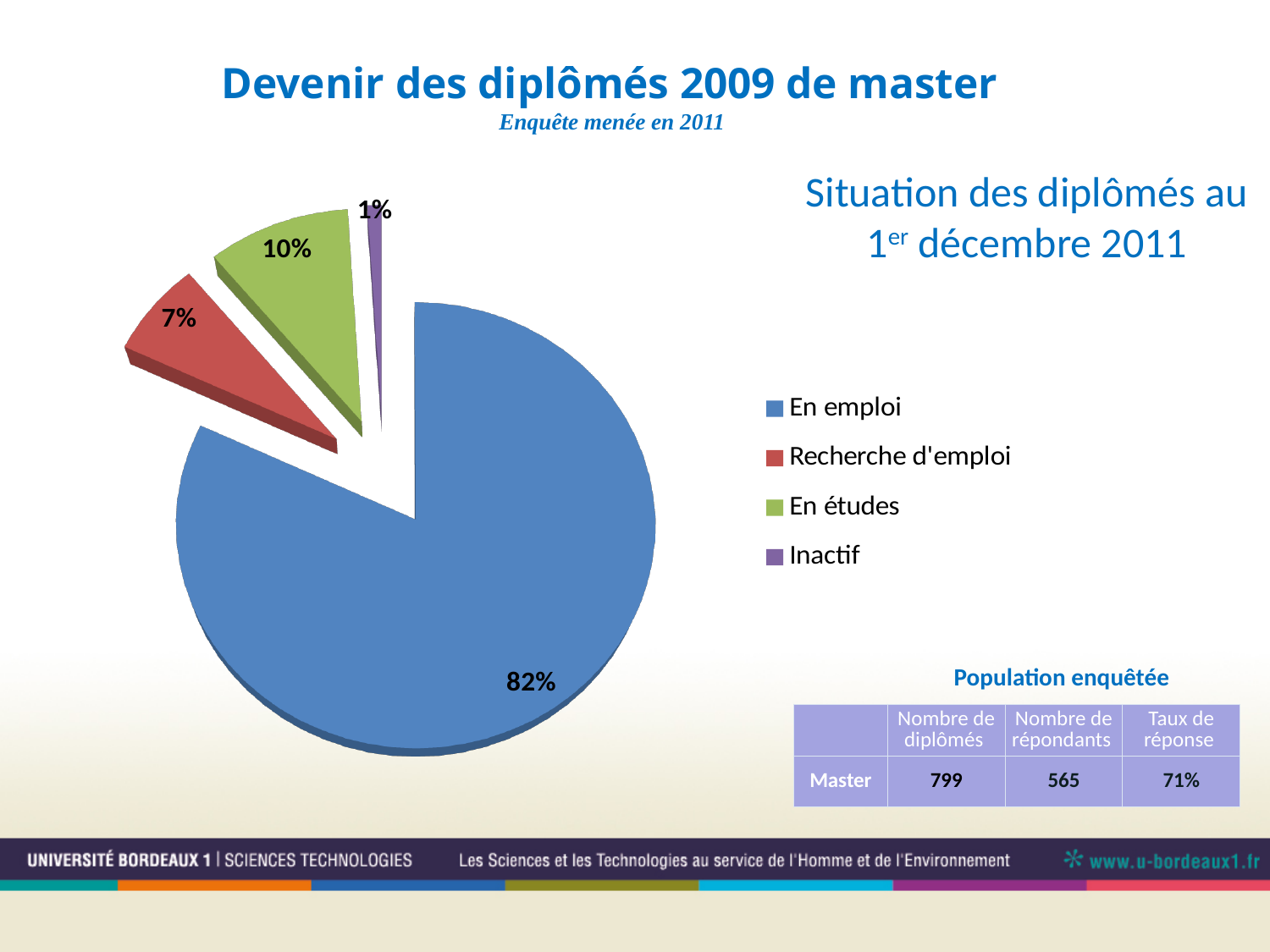
How many categories does the pie chart show? 4 What share of the pie does "Recherche d'emploi" represent? 7% What colour is the slice for "Recherche d'emploi"? Red What share of the pie does "En emploi" represent? 82% What share of the pie does "Inactif" represent? 1% Which is larger, the slice for "En études" or the slice for "Recherche d'emploi"? En études Which category has the largest slice of the pie? En emploi Which category has the smallest slice of the pie? Inactif What is the difference in percentage points between "En emploi" and "En études"? 72 What kind of chart is shown on the slide? Pie chart What is the difference in percentage points between "En études" and "Recherche d'emploi"? 3